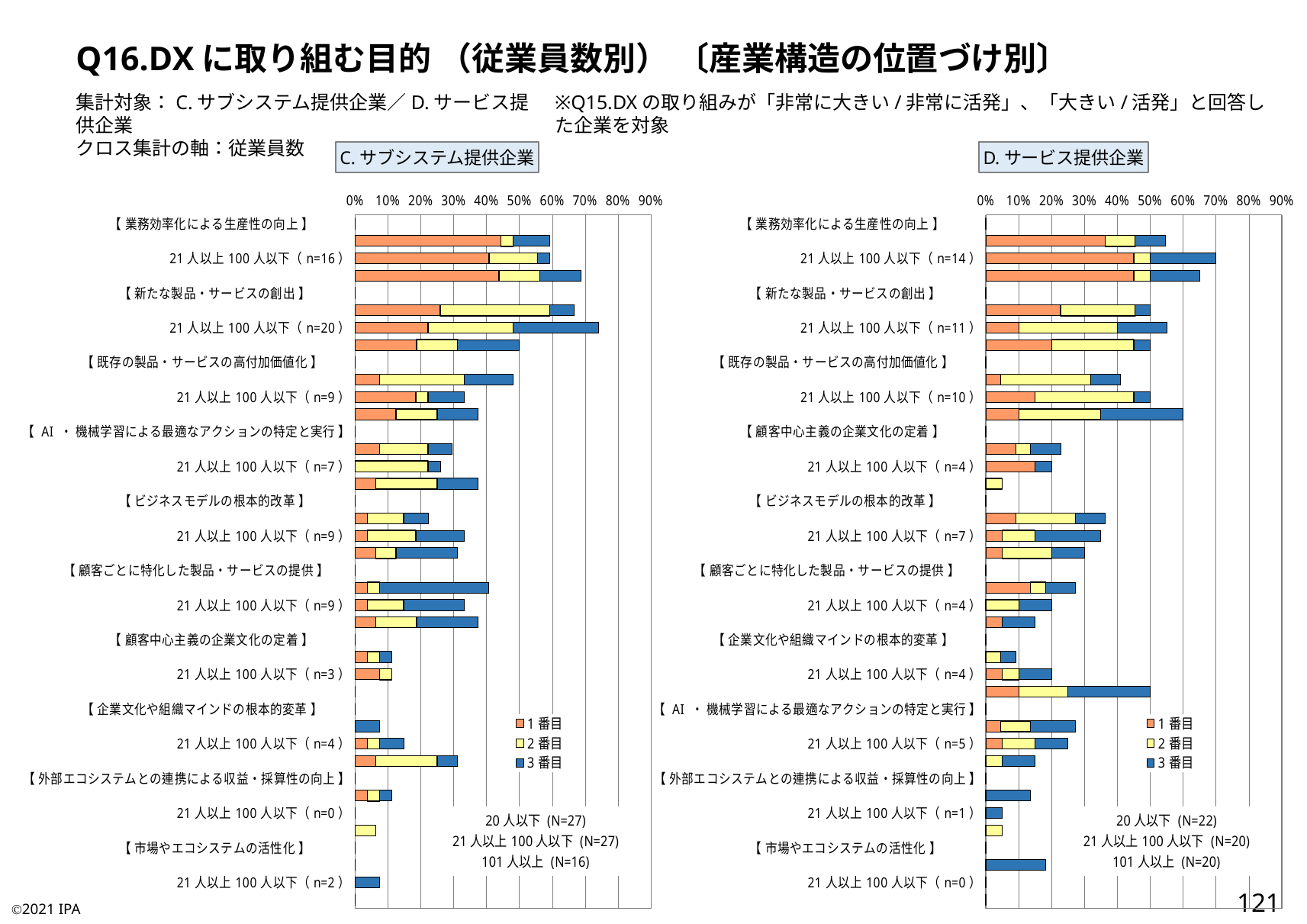
In the C. サブシステム提供企業 chart, is the total bar for 101人以上 under 【業務効率化による生産性の向上】 greater or less than 60%? greater In the D. サービス提供企業 chart, is the total bar for 101人以上 under 【企業文化や組織マインドの根本的変革】 greater or less than 40%? greater What are the legend entries of the C. サブシステム提供企業 chart? 1番目, 2番目, 3番目 In the D. サービス提供企業 chart, is the bar for 101人以上 under 【顧客中心主義の企業文化の定着】 greater or less than 10%? less How many series does the legend of the D. サービス提供企業 chart list? 3 What kind of chart is the C. サブシステム提供企業 chart on the left? Stacked horizontal bar chart In the C. サブシステム提供企業 chart, which total bar is longer: 21人以上100人以下 (n=20) under 【新たな製品・サービスの創出】 or 101人以上 under 【業務効率化による生産性の向上】? 21人以上100人以下 (n=20) under 【新たな製品・サービスの創出】 According to the note in the D. サービス提供企業 chart, what is the N for 20人以下? N=22 How many purpose categories (bracketed headings) are shown in the D. サービス提供企業 chart? 10